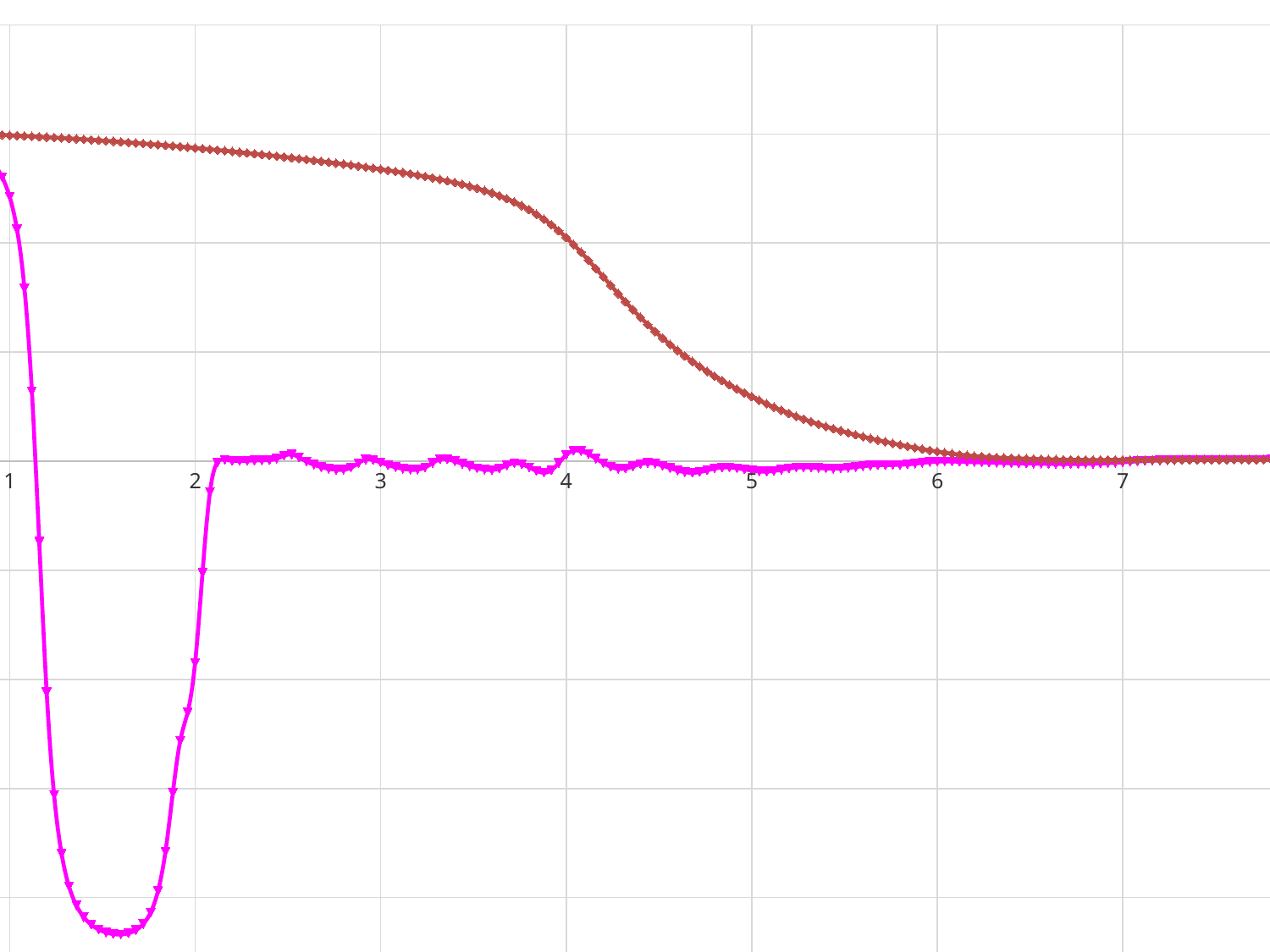
At x = 1.5, which line is lower: the brown line or the magenta line? the magenta line Does the magenta line rise or fall between x = 1 and x = 1.5? fall What kind of chart is shown on the slide? line chart Does the brown line with diamond markers rise or fall as x increases from 1 to 7? fall Does the magenta line rise or fall between x = 1.5 and x = 2? rise How many lines are plotted on the chart? 2 What marker shape is used on the magenta line? triangles At x = 4, which line is higher: the brown line or the magenta line? the brown line What is the highest x-axis tick label shown on the chart? 7